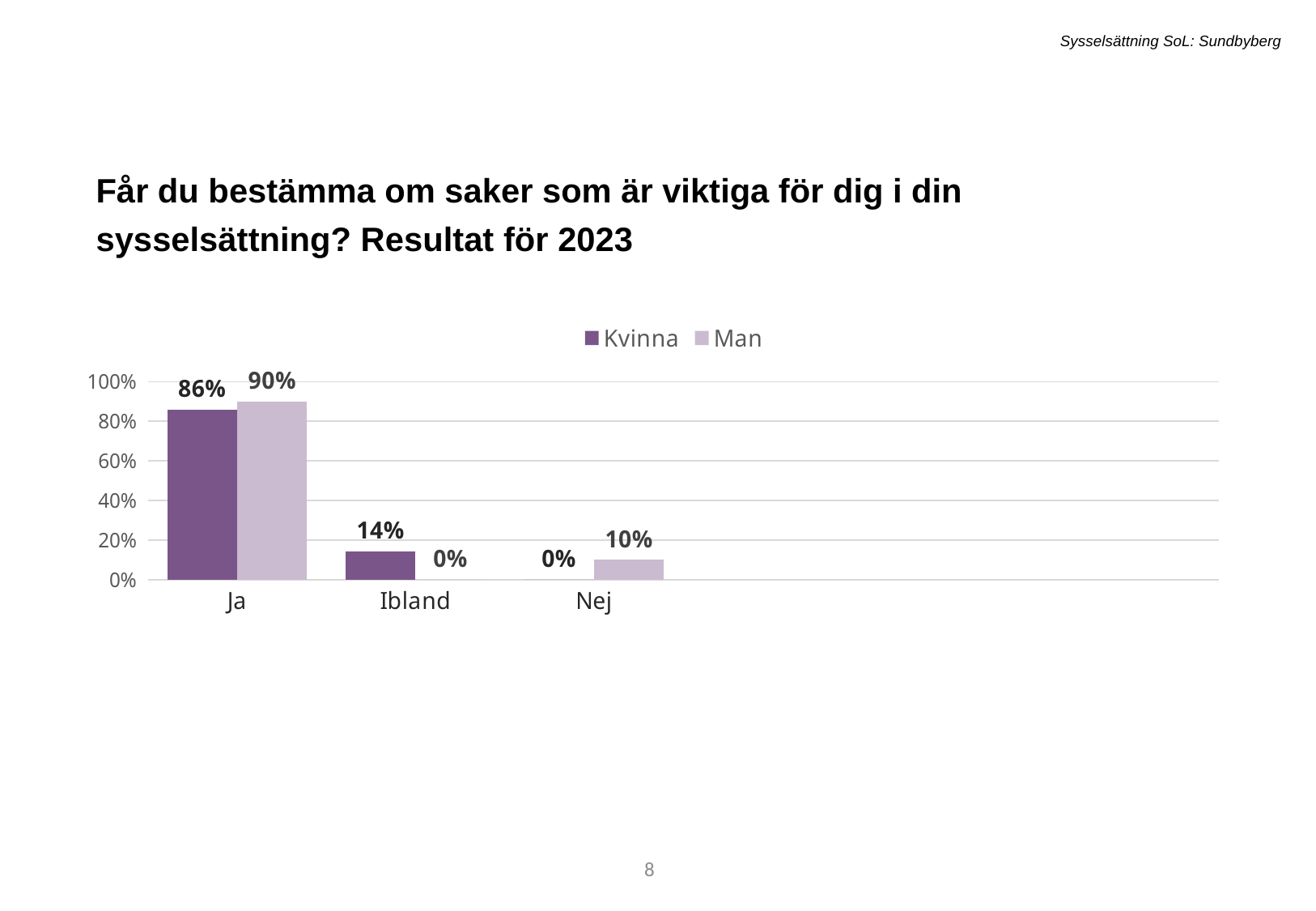
What is the value for Man in the Nej category? 10% What is the value for Man in the Ja category? 90% What is the difference between the Man and Kvinna values in the Ja category? 4% What kind of chart is shown on the slide? Bar chart What is the value for Kvinna in the Ibland category? 14% How many categories are shown on the x axis? 3 Which category has the highest value for Kvinna? Ja Which is larger in the Ja category, Kvinna or Man? Man How many series does the legend list? 2 What is the value for Kvinna in the Ja category? 86% What is the value for Man in the Ibland category? 0% Which category has the lowest value for Man? Ibland